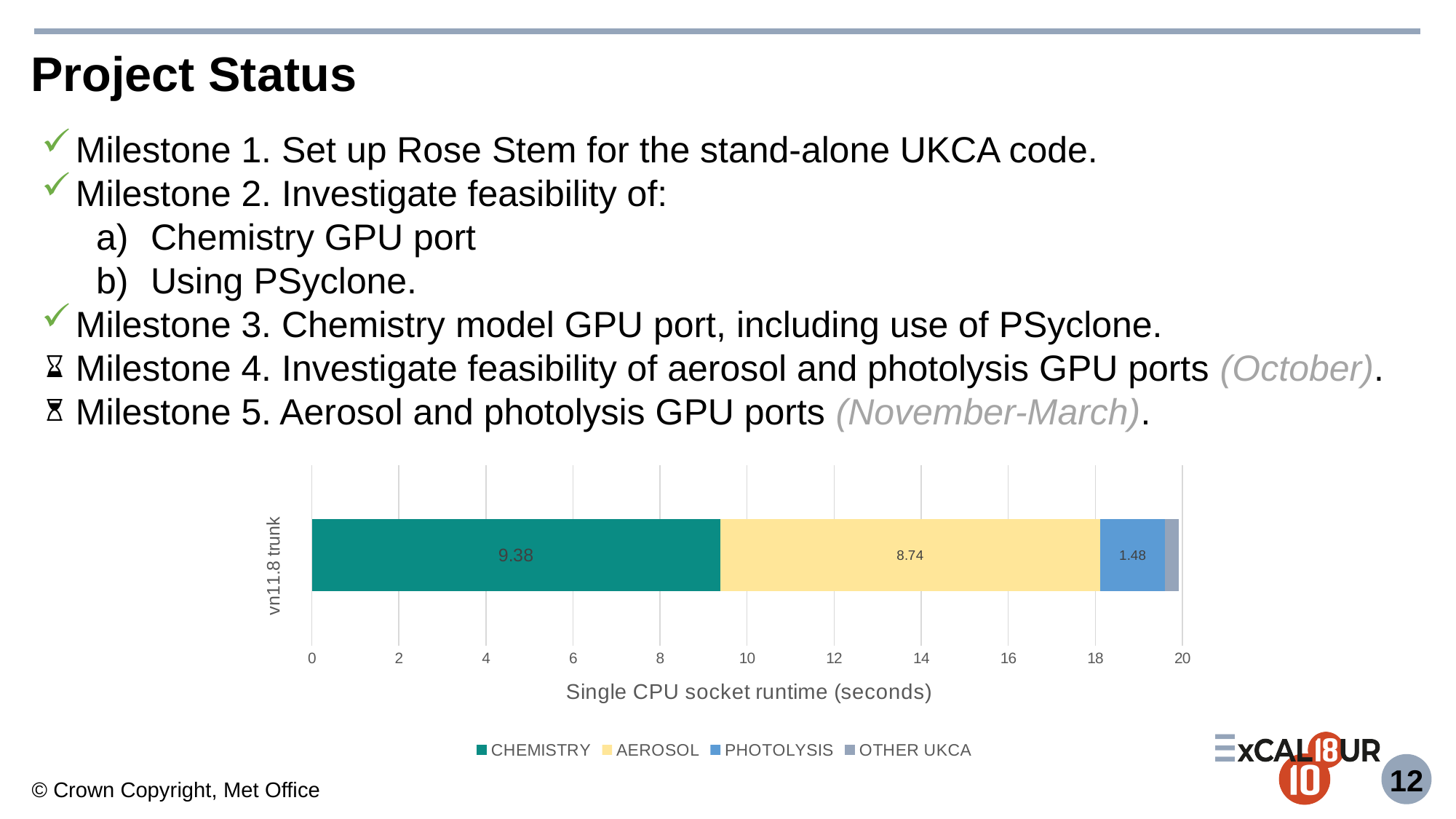
How many series does the legend list? 4 What kind of chart is shown on the slide? bar chart What is the difference between the AEROSOL and PHOTOLYSIS values for vn11.8 trunk? 7.26 Which series has the smallest segment in the vn11.8 trunk bar? OTHER UKCA What is the difference between the CHEMISTRY and AEROSOL values for vn11.8 trunk? 0.64 What is the CHEMISTRY value for vn11.8 trunk? 9.38 What is the x-axis title of the chart? Single CPU socket runtime (seconds) Which series has the largest segment in the vn11.8 trunk bar? CHEMISTRY What is the AEROSOL value for vn11.8 trunk? 8.74 Is the total length of the vn11.8 trunk bar greater or less than 18? greater What is the PHOTOLYSIS value for vn11.8 trunk? 1.48 Which is larger for vn11.8 trunk, the CHEMISTRY value or the AEROSOL value? CHEMISTRY